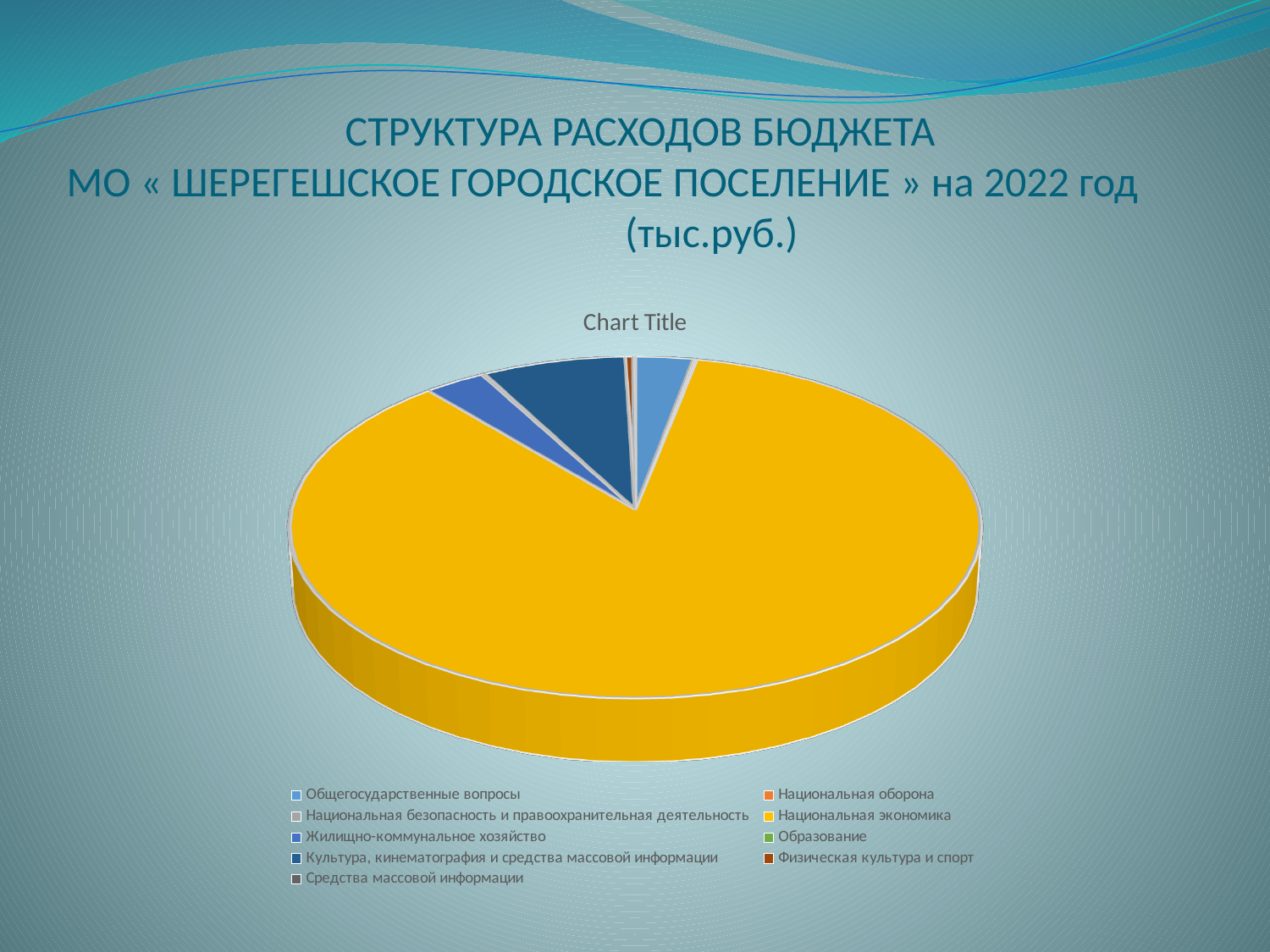
What kind of chart is shown on the slide? Pie chart Which is larger: the slice for Национальная экономика or the slice for Культура, кинематография и средства массовой информации? Национальная экономика Which is larger: the slice for Национальная экономика or the slice for Общегосударственные вопросы? Национальная экономика How many categories does the legend list? 9 Which is larger: the slice for Культура, кинематография и средства массовой информации or the slice for Жилищно-коммунальное хозяйство? Культура, кинематография и средства массовой информации What title is printed directly above the pie chart? Chart Title Which category has the largest slice of the pie? Национальная экономика What colour is the largest slice of the pie? Yellow